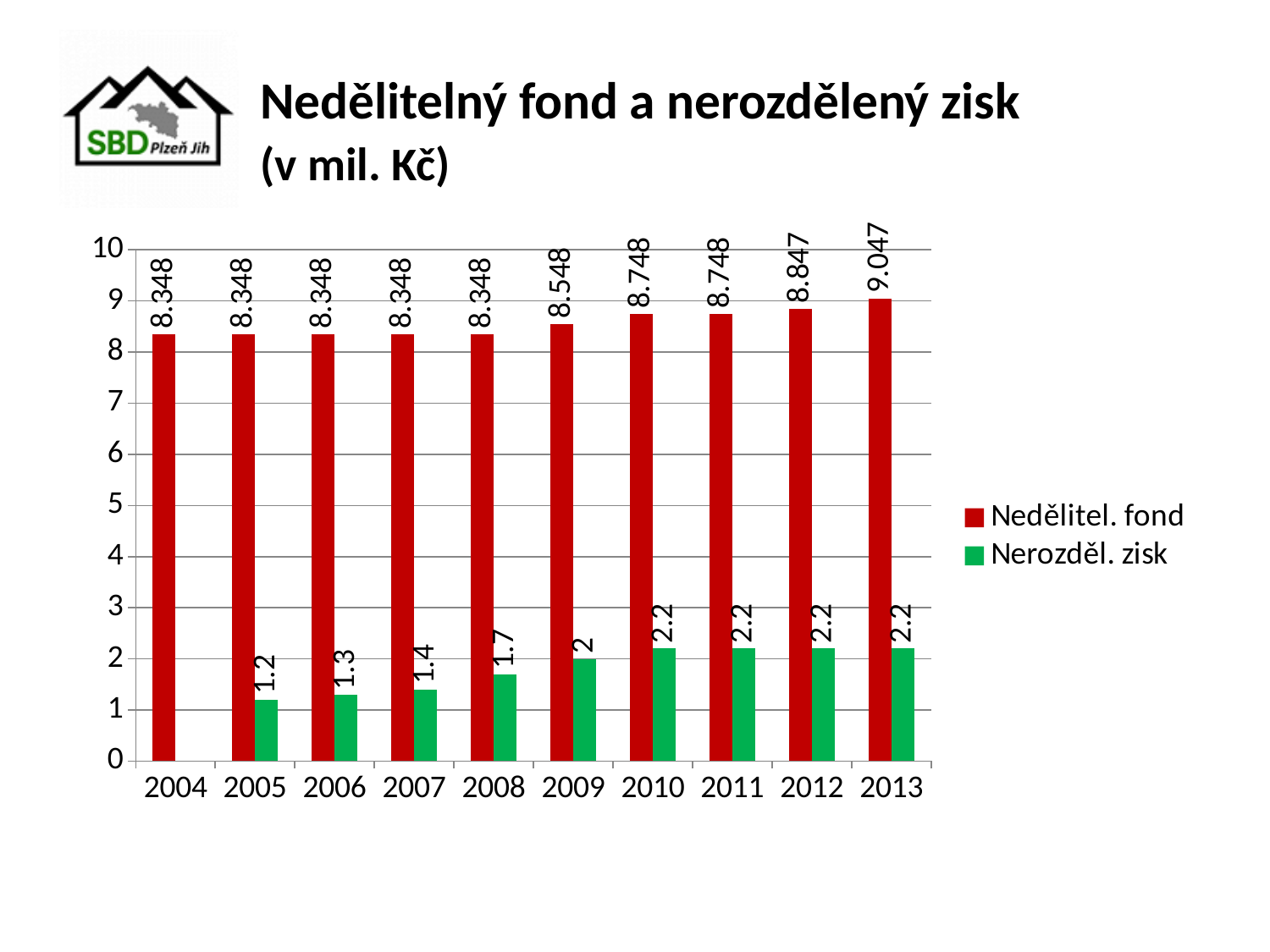
How many series does the legend list? 2 In which year is Nedělitel. fond highest? 2013 Is the value of Nedělitel. fond in 2012 greater or less than 8? greater How many years are shown on the x axis? 10 Which is larger in 2010: Nedělitel. fond or Nerozděl. zisk? Nedělitel. fond What is the value of Nedělitel. fond in 2013? 9.047 What is the value of Nedělitel. fond in 2009? 8.548 What is the value of Nerozděl. zisk in 2008? 1.7 What is the difference between Nedělitel. fond in 2013 and in 2004? 0.699 In which year is Nerozděl. zisk lowest among the years where it is shown? 2005 Does Nerozděl. zisk rise or fall from 2005 to 2010? rise What kind of chart is shown on the slide? bar chart